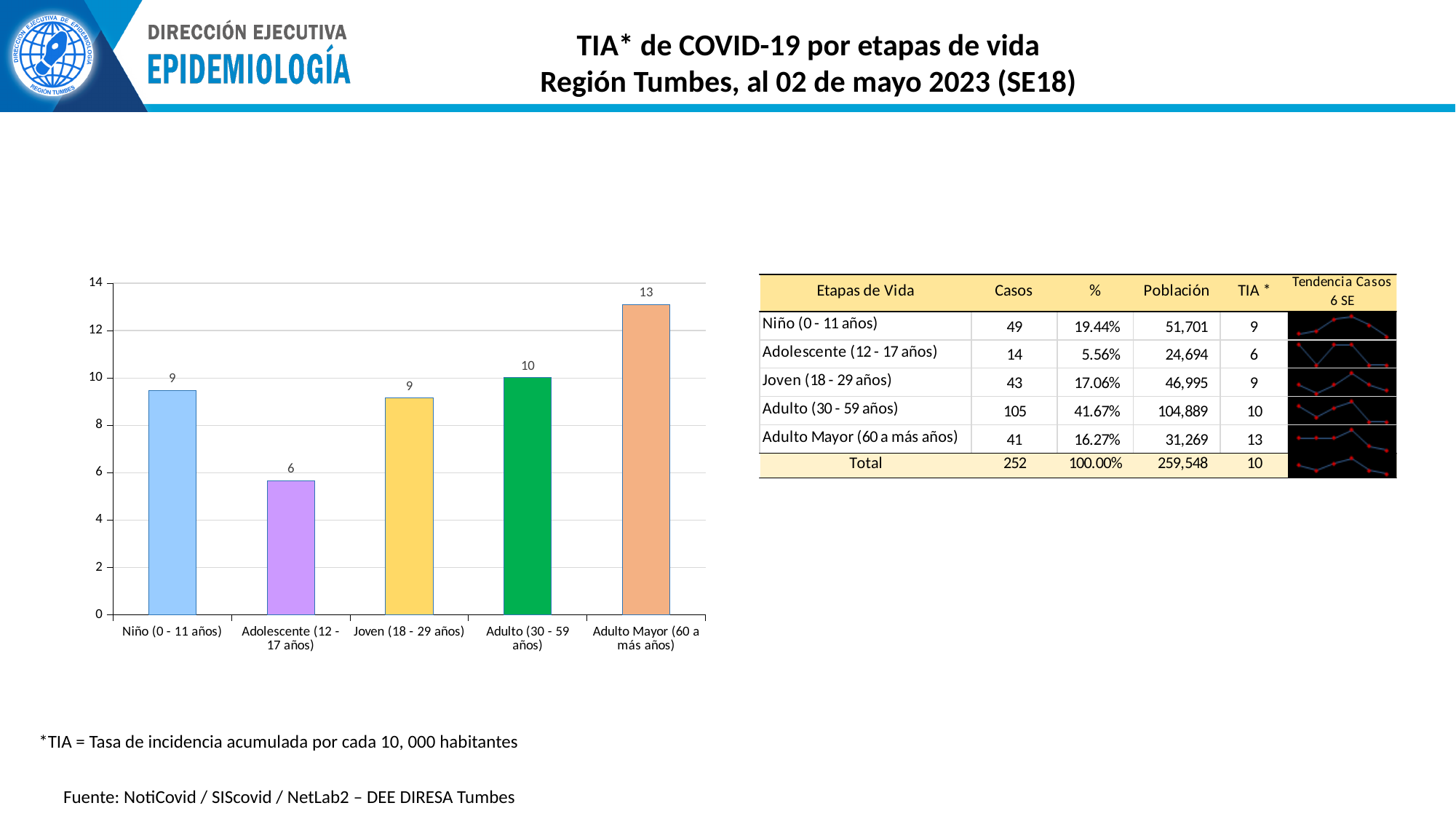
What is the maximum value shown on the vertical axis of the bar chart? 14 What is the TIA value shown for Adolescente (12 - 17 años) in the bar chart? 6 What is the difference between the TIA for Adulto Mayor (60 a más años) and Adolescente (12 - 17 años) in the bar chart? 7 How many life-stage categories are shown in the bar chart? 5 Which life stage has the lowest TIA in the bar chart? Adolescente (12 - 17 años) Is the TIA value for Adulto Mayor (60 a más años) in the bar chart greater or less than 12? greater What type of chart is used to show TIA by life stage on this slide? Bar chart In the bar chart, which is larger: the TIA for Adulto (30 - 59 años) or for Adolescente (12 - 17 años)? Adulto (30 - 59 años) What is the TIA value shown for Adulto Mayor (60 a más años) in the bar chart? 13 Which life stage has the highest TIA in the bar chart? Adulto Mayor (60 a más años) Is the TIA value for Adolescente (12 - 17 años) in the bar chart greater or less than 8? less What is the TIA value shown for Adulto (30 - 59 años) in the bar chart? 10